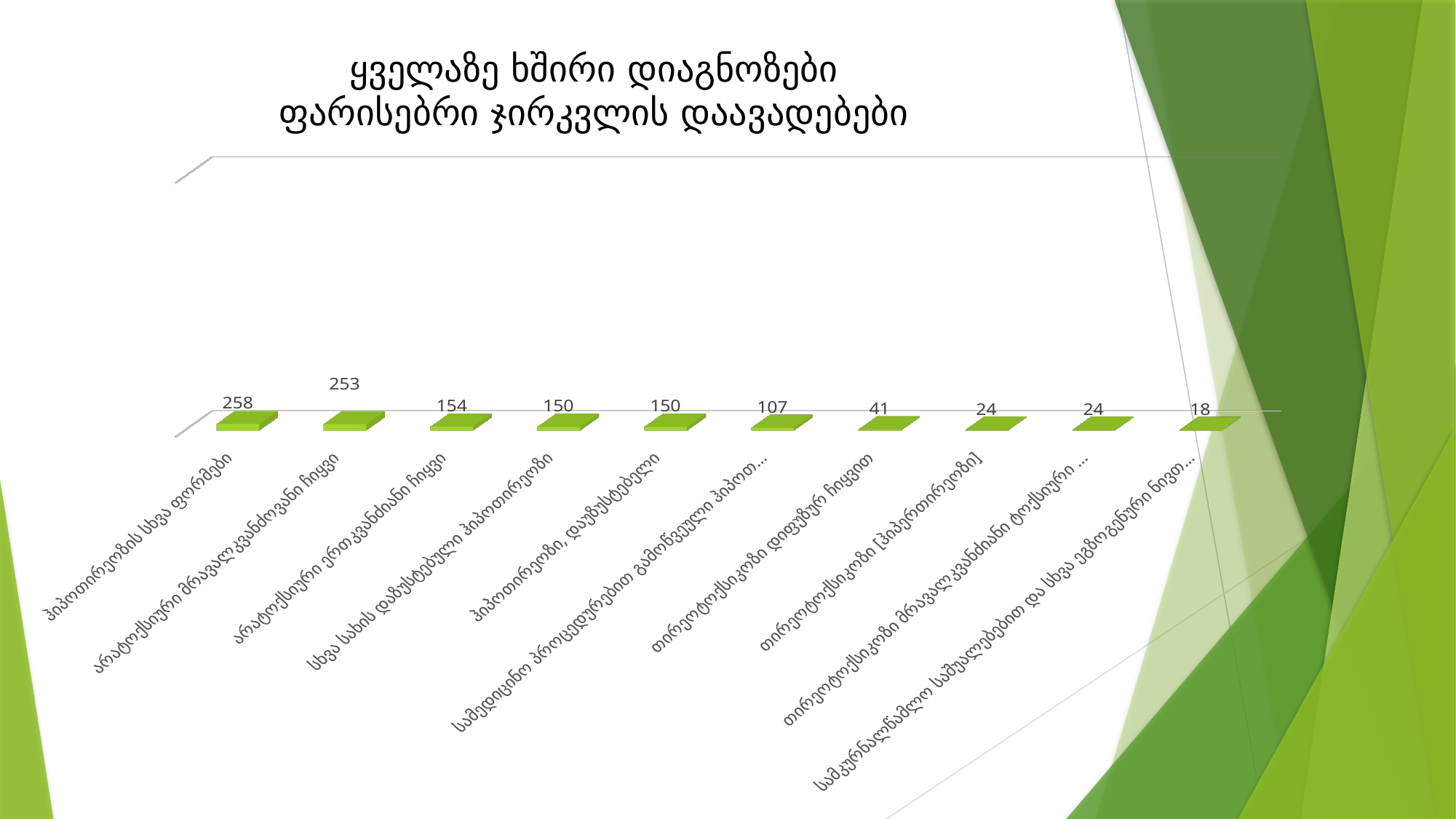
What is the title of the chart? ყველაზე ხშირი დიაგნოზები ფარისებრი ჯირკვლის დაავადებები Which category has the highest value? ჰიპოთირეოზის სხვა ფორმები What is the difference between the values for ჰიპოთირეოზის სხვა ფორმები and არატოქსიური მრავალკვანძოვანი ჩიყვი? 5 Do the values generally rise or fall from left to right along the x axis? fall What is the value for თირეოტოქსიკოზი დიფუზური ჩიყვით? 41 How many categories are plotted in the chart? 10 Which is larger: the value for არატოქსიური ერთკვანძიანი ჩიყვი or the value for თირეოტოქსიკოზი [ჰიპერთირეოზი]? არატოქსიური ერთკვანძიანი ჩიყვი What is the value for არატოქსიური ერთკვანძიანი ჩიყვი? 154 What type of chart is shown on the slide? bar chart What is the lowest value shown in the chart? 18 What is the value for არატოქსიური მრავალკვანძოვანი ჩიყვი? 253 What is the value for ჰიპოთირეოზის სხვა ფორმები? 258